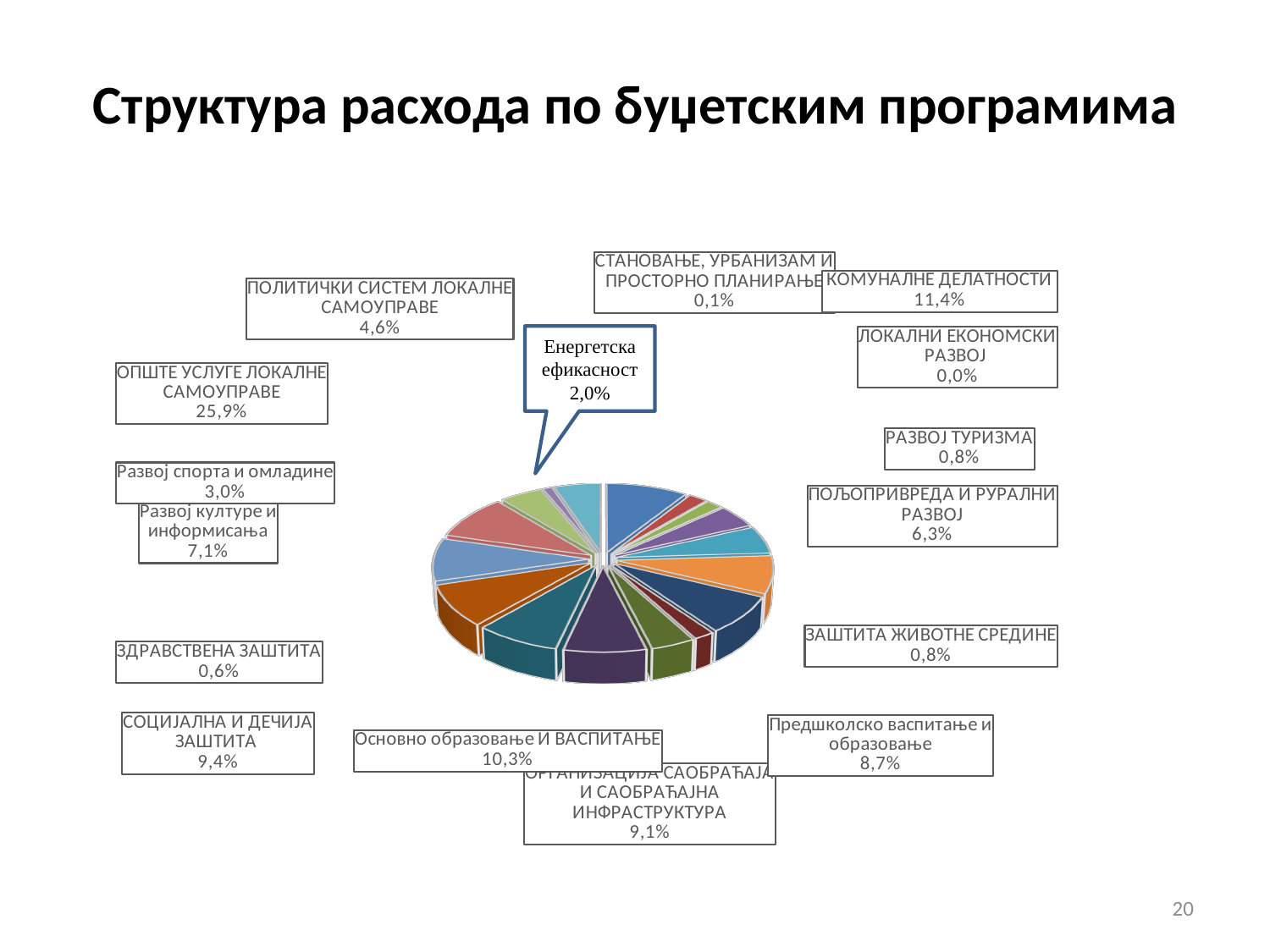
What share of expenditure goes to ОПШТЕ УСЛУГЕ ЛОКАЛНЕ САМОУПРАВЕ? 25,9% How many budget programmes are labelled on the pie chart? 16 Which budget programme has the smallest share of expenditure? ЛОКАЛНИ ЕКОНОМСКИ РАЗВОЈ What is the difference in percentage points between ОПШТЕ УСЛУГЕ ЛОКАЛНЕ САМОУПРАВЕ and КОМУНАЛНЕ ДЕЛАТНОСТИ? 14,5 What is the title of the slide? Структура расхода по буџетским програмима Which budget programme has the largest share of expenditure? ОПШТЕ УСЛУГЕ ЛОКАЛНЕ САМОУПРАВЕ What kind of chart is shown on the slide? Pie chart What share is shown for Предшколско васпитање и образовање? 8,7% What percentage is labelled for Енергетска ефикасност? 2,0% Which has a larger share: КОМУНАЛНЕ ДЕЛАТНОСТИ or Основно образовање И ВАСПИТАЊЕ? КОМУНАЛНЕ ДЕЛАТНОСТИ What share is shown for КОМУНАЛНЕ ДЕЛАТНОСТИ? 11,4% What is the difference in percentage points between Основно образовање И ВАСПИТАЊЕ and Предшколско васпитање и образовање? 1,6